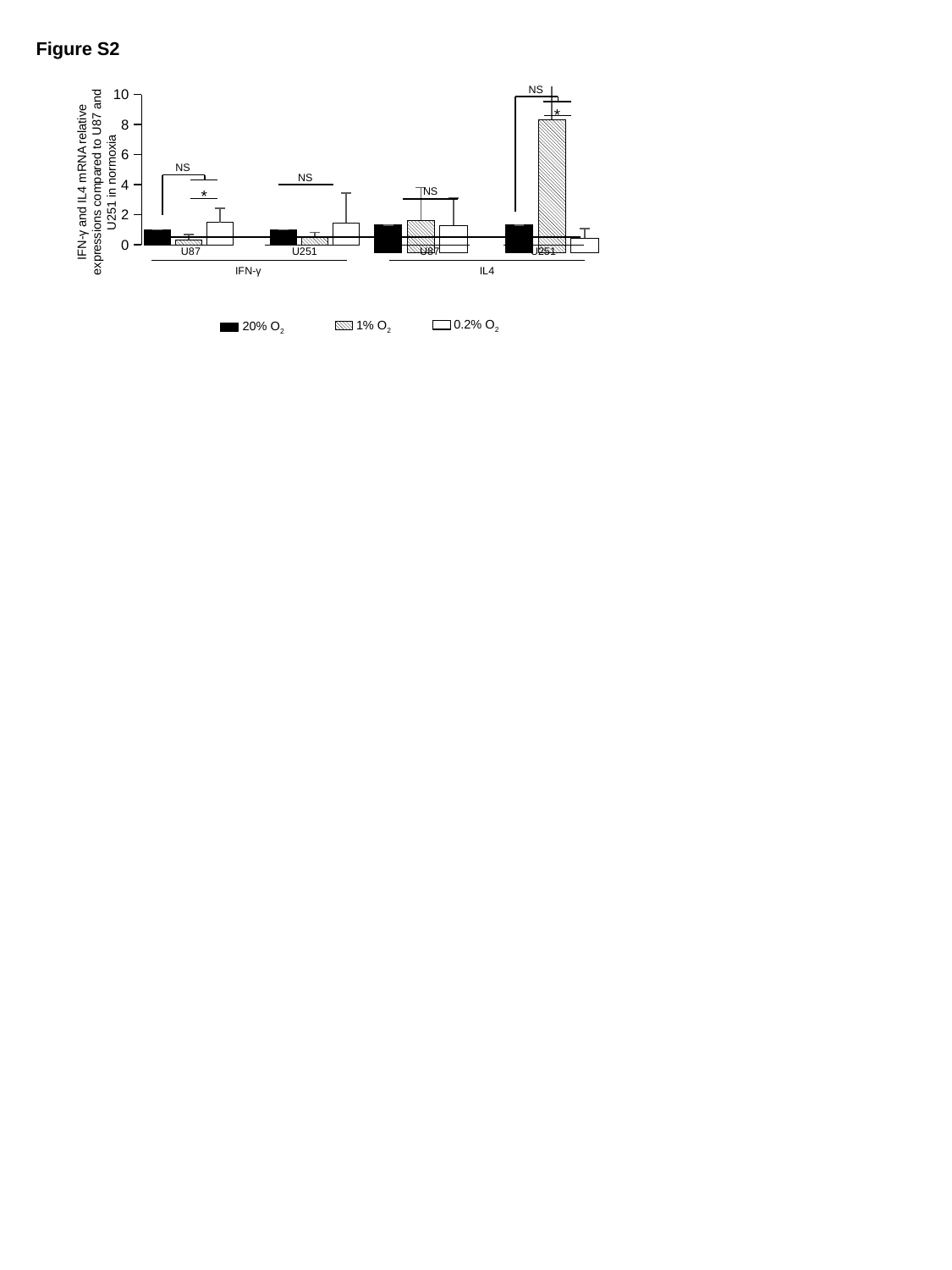
Which is larger: the 1% O2 bar for U251 under IL4 or the 1% O2 bar for U87 under IL4? 1% O2 for U251 under IL4 How many cell-line groups (category groups) are plotted along the x axis? 4 How many series does the legend list? 3 Which is larger: the 1% O2 bar for U251 under IL4 or the 20% O2 bar for U251 under IL4? 1% O2 for U251 under IL4 What kind of chart is shown on the slide? bar chart Is the value for 0.2% O2 in U251 under IL4 greater or less than 2? less What is the maximum value shown on the y axis? 10 What are the three series listed in the legend? 20% O2, 1% O2, 0.2% O2 Is the value for 1% O2 in U251 under IL4 greater or less than 6? greater Which bar is the highest in the chart? 1% O2 for U251 under IL4 Is the value for 20% O2 in U87 under IFN-γ greater or less than 2? less Which two cytokines are labelled beneath the x axis? IFN-γ and IL4